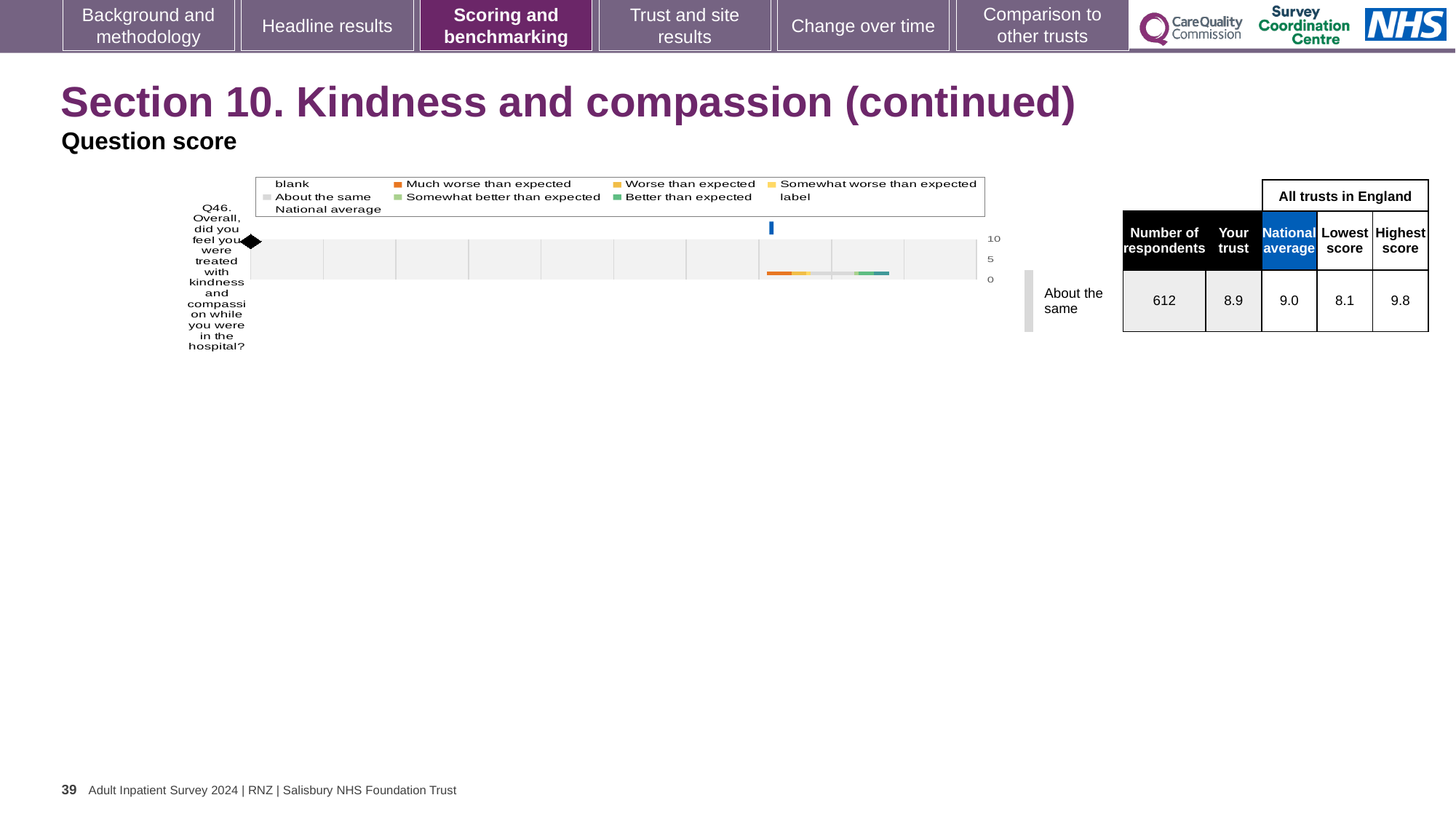
In the table beside the chart, which is larger for Q46: the 'Your trust' score or the national average? National average How many entries does the chart legend list? 9 In the table beside the chart, what is the highest score among all trusts in England for Q46? 9.8 According to the label next to the chart, how is the trust's result for Q46 categorised? About the same In the table beside the chart, what is the 'Your trust' score for Q46? 8.9 Which question is plotted on the chart? Q46. Overall, did you feel you were treated with kindness and compassion while you were in the hospital? In the table beside the chart, what is the number of respondents for Q46? 612 What is the highest value shown on the chart's axis? 10 How many questions (categories) are plotted on the chart? 1 In the table beside the chart, what is the national average score for Q46? 9.0 What kind of chart is shown on the slide? bar chart In the table beside the chart, what is the lowest score among all trusts in England for Q46? 8.1